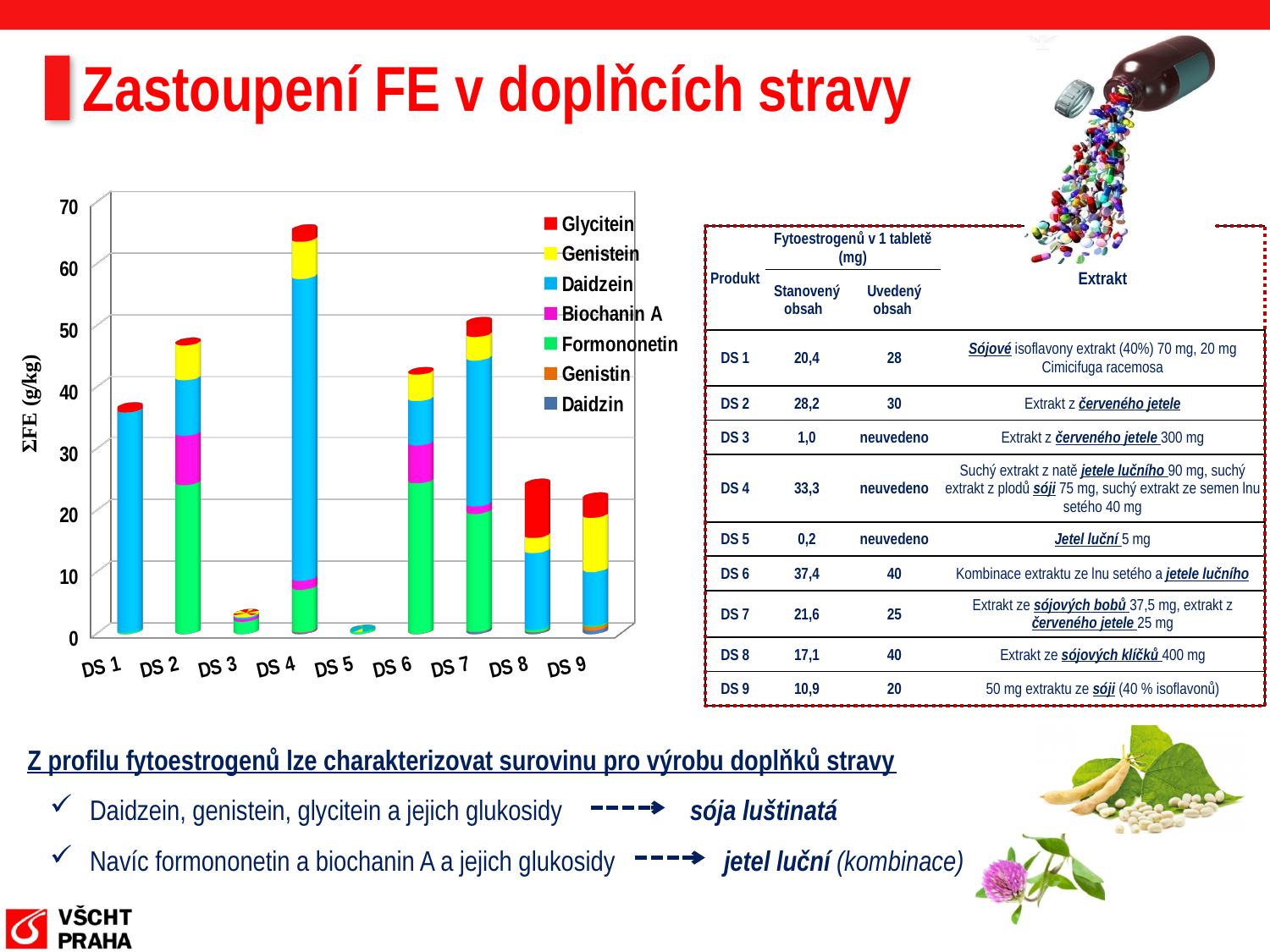
What kind of chart is shown on the slide? stacked bar chart Which product has the lowest total ΣFE in the chart? DS 5 Is the total value for DS 7 greater or less than 40? greater How many products (categories) are shown on the x axis of the chart? 9 What is the label of the y axis of the chart? ΣFE (g/kg) Which product has the highest total ΣFE in the chart? DS 4 Is the total value for DS 1 greater or less than 40? less Is the total value for DS 4 greater or less than 60? greater Which has the larger total ΣFE, DS 7 or DS 6? DS 7 How many series does the chart legend list? 7 Which has the larger total ΣFE, DS 2 or DS 1? DS 2